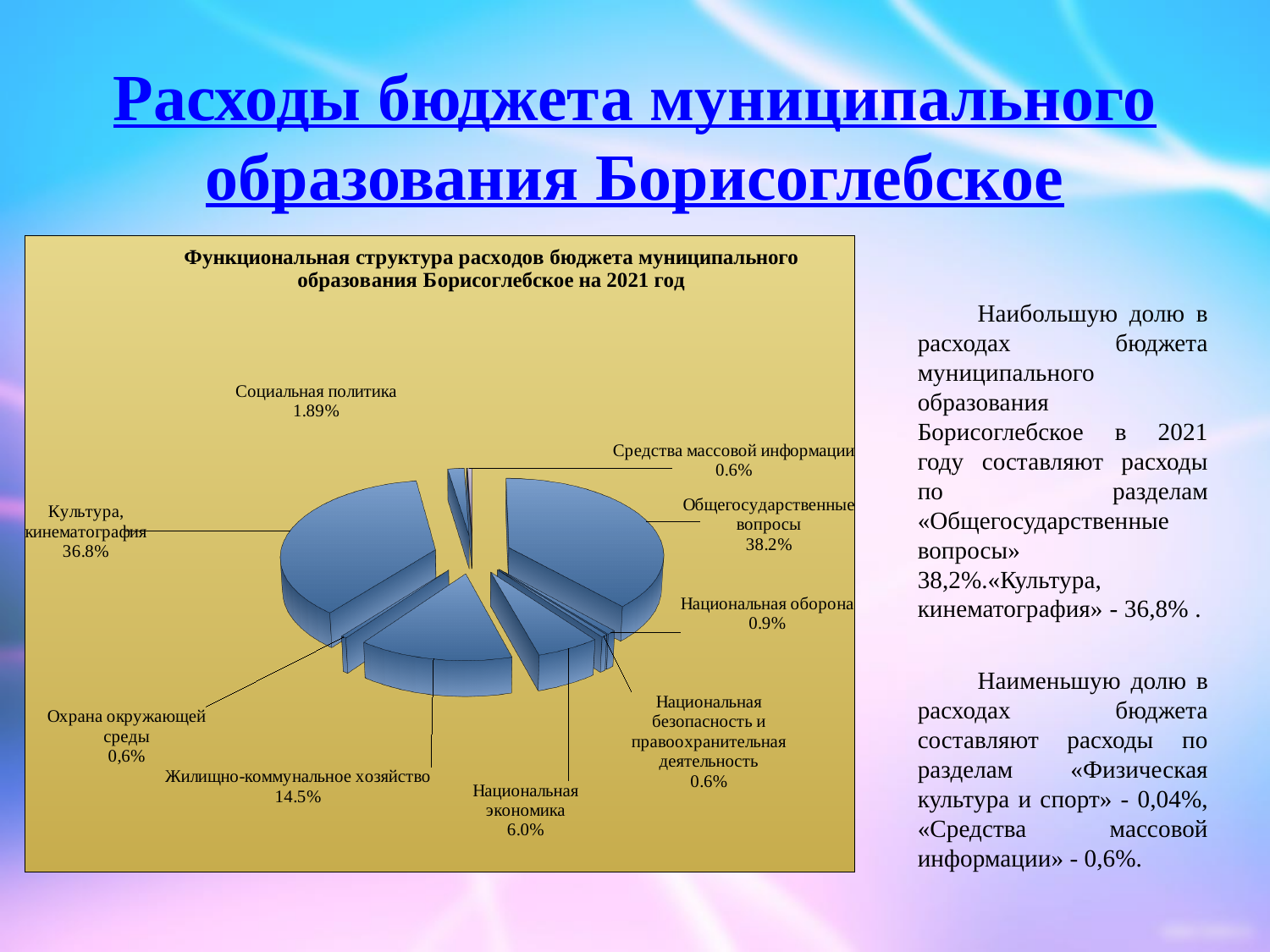
What is the title of the chart? Функциональная структура расходов бюджета муниципального образования Борисоглебское на 2021 год What share of the pie is labeled for Культура, кинематография? 36.8% What share of the pie is labeled for Национальная экономика? 6.0% What kind of chart is shown on the slide? pie chart What share of the pie is labeled for Жилищно-коммунальное хозяйство? 14.5% Which has a larger share: Жилищно-коммунальное хозяйство or Национальная экономика? Жилищно-коммунальное хозяйство What is the difference in percentage points between Общегосударственные вопросы and Культура, кинематография? 1.4 What share of the pie is labeled for Социальная политика? 1.89% What share of the pie is labeled for Национальная оборона? 0.9% Which category has the largest share of the pie? Общегосударственные вопросы How many categories are labeled on the pie chart? 9 What share of the pie is labeled for Общегосударственные вопросы? 38.2%